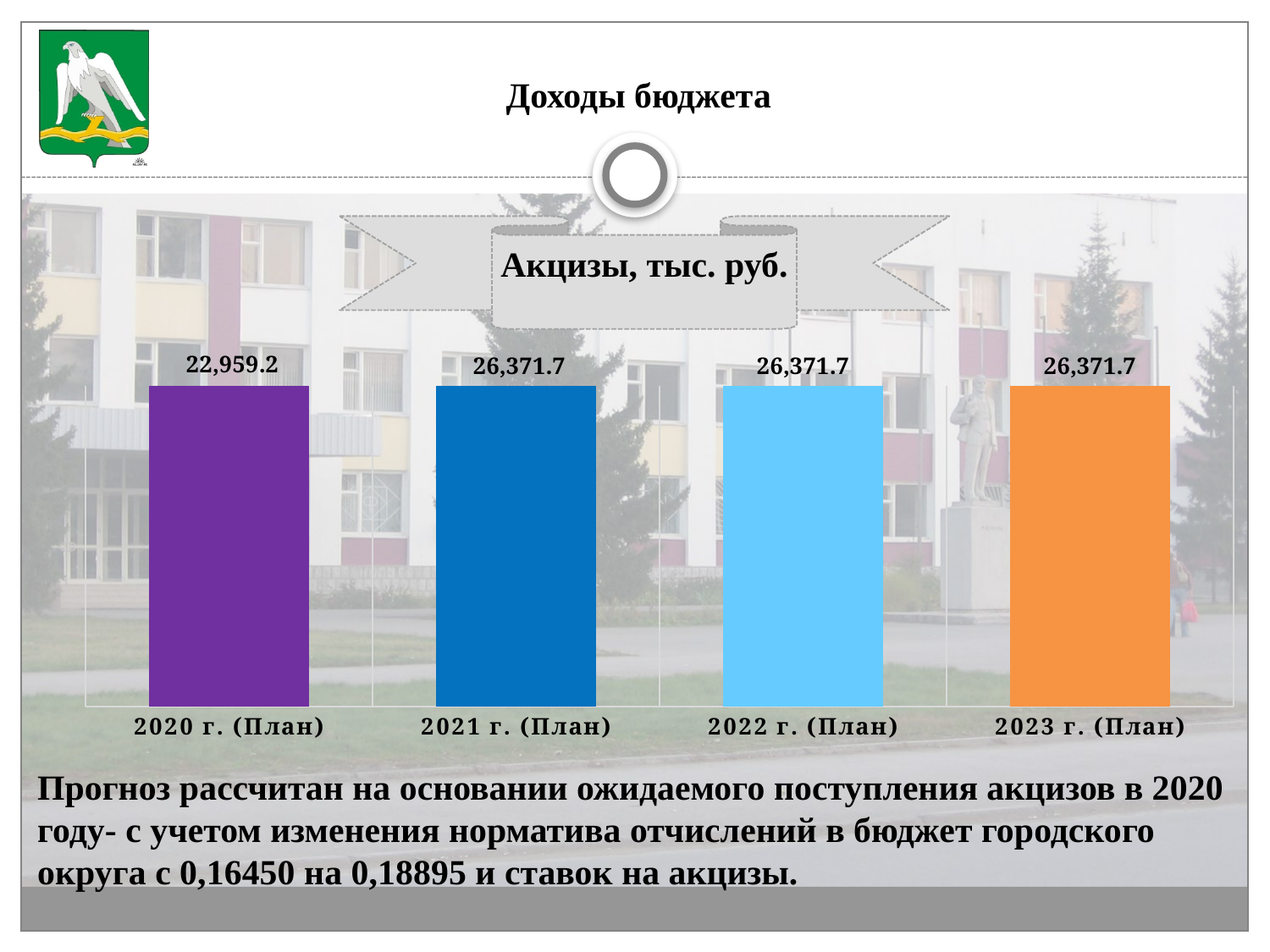
Are the values for 2022 г. (План) and 2023 г. (План) equal? Yes What is the value for 2023 г. (План)? 26,371.7 What colour is the bar for 2023 г. (План)? Orange Which year has the lowest value? 2020 г. (План) What is the value for 2021 г. (План)? 26,371.7 What is the value for 2020 г. (План)? 22,959.2 Which is larger, the value for 2020 г. (План) or 2021 г. (План)? 2021 г. (План) What is the difference between the values for 2021 г. (План) and 2020 г. (План)? 3,412.5 What is the title of the chart? Акцизы, тыс. руб. How many bars are shown in the chart? 4 What kind of chart is shown? Bar chart Do the values rise or fall from 2020 to 2021? Rise